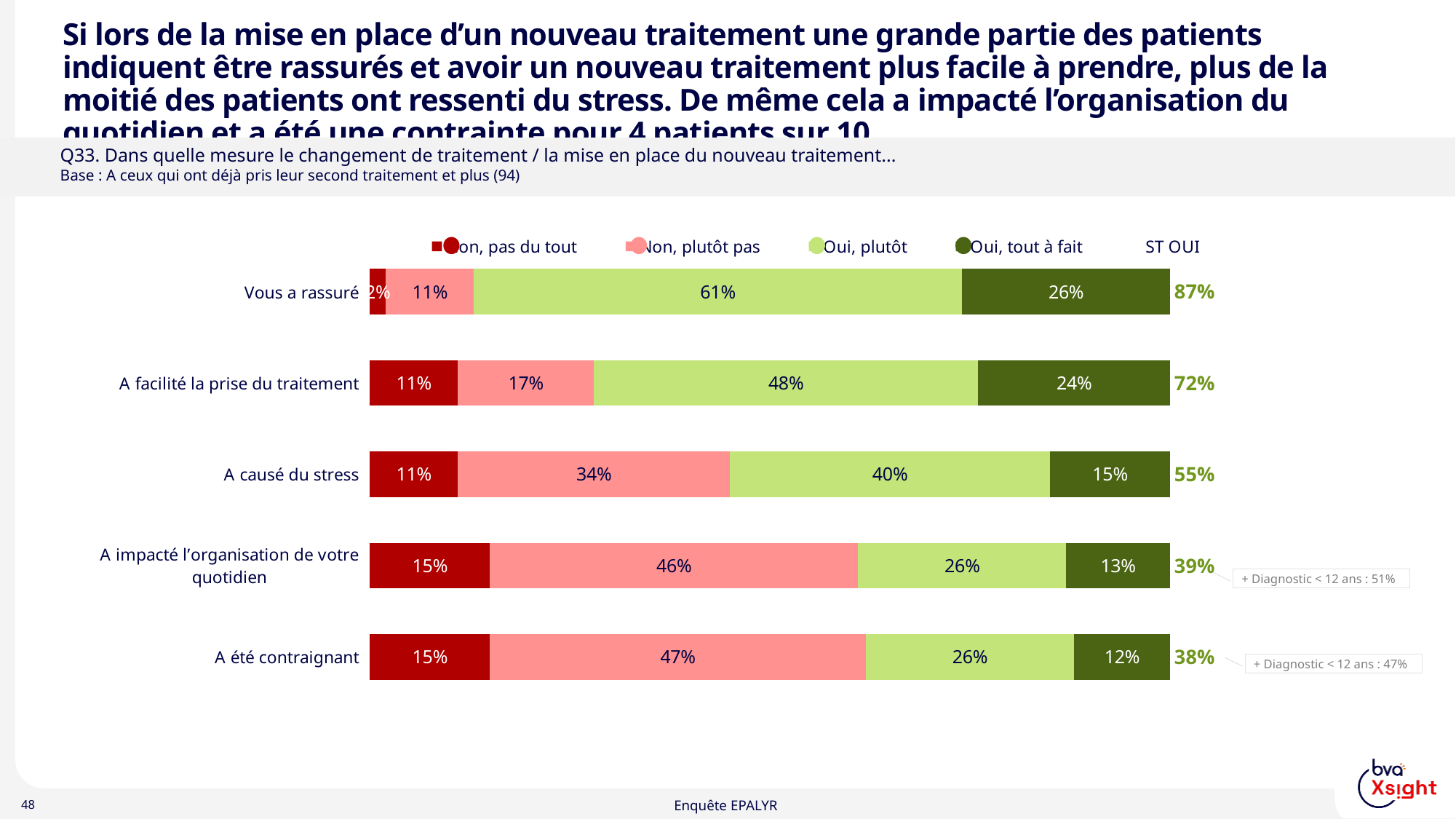
What is the difference between the 'Oui, plutôt' values for 'Vous a rassuré' and 'A causé du stress'? 21 percentage points What is the total of the 'Oui, plutôt' and 'Oui, tout à fait' values for 'A causé du stress'? 55% What is the 'Non, plutôt pas' value for 'A causé du stress'? 34% What is the 'Oui, plutôt' value for 'Vous a rassuré'? 61% How many categories (statements) are plotted in the chart? 5 Which is larger: the 'Non, plutôt pas' value for 'A été contraignant' or for 'A facilité la prise du traitement'? A été contraignant What kind of chart is shown on the slide? stacked bar chart What is the 'Oui, tout à fait' value for 'A facilité la prise du traitement'? 24% What is the ST OUI value for 'A impacté l'organisation de votre quotidien'? 39% How many series does the chart legend list? 5 Which statement has the highest ST OUI value? Vous a rassuré Which statement has the lowest ST OUI value? A été contraignant